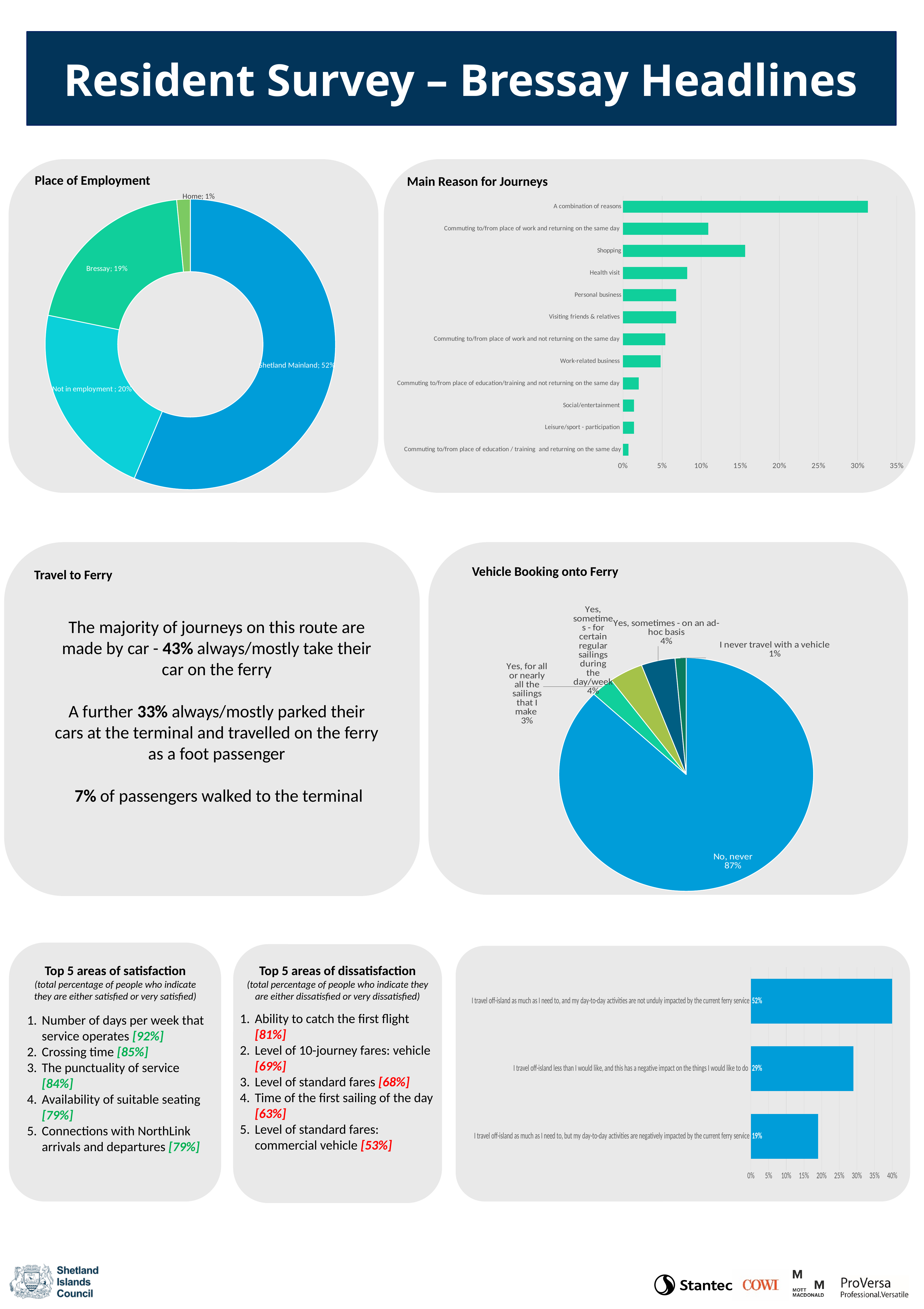
In the Place of Employment chart, what percentage of respondents work on the Shetland Mainland? 52% In the Main Reason for Journeys chart, is the value for Health visit greater or less than 10%? less In the bar chart at the bottom right of the slide, what percentage said they travel off-island less than they would like, and this has a negative impact on the things they would like to do? 29% In the Main Reason for Journeys chart, is the value for Shopping greater or less than 10%? greater How many reasons are listed in the Main Reason for Journeys chart? 12 In the Place of Employment chart, what percentage of respondents are not in employment? 20% In the Vehicle Booking onto Ferry chart, what percentage answered 'No, never'? 87% What type of chart is the Place of Employment chart? Donut (pie) chart In the Vehicle Booking onto Ferry chart, what percentage answered 'Yes, for all or nearly all the sailings that I make'? 3% In the Place of Employment chart, what is the difference between the Bressay share and the Home share? 18% In the Main Reason for Journeys chart, which reason has the longest bar? A combination of reasons In the Main Reason for Journeys chart, which is larger: Shopping or Health visit? Shopping